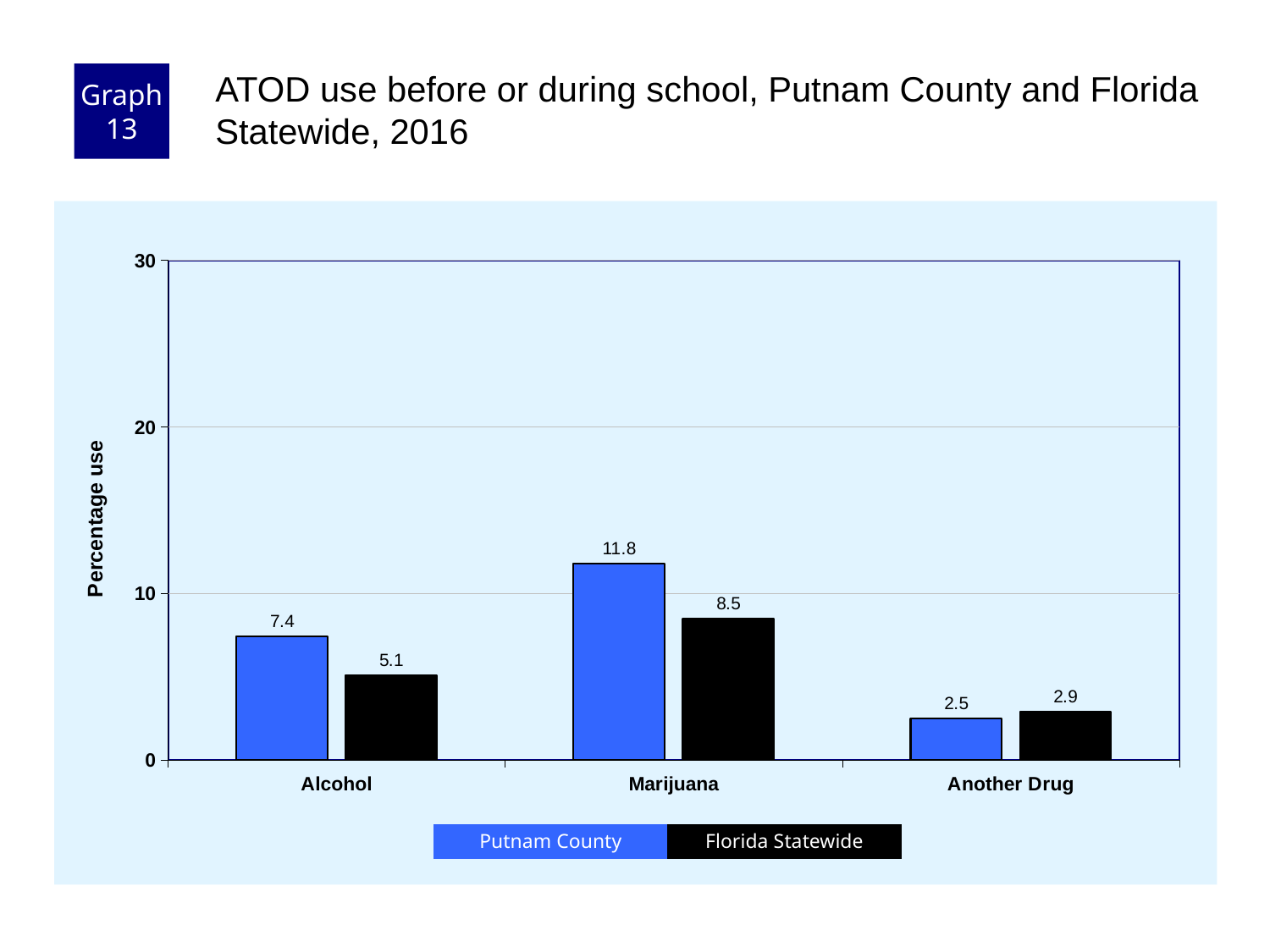
Which category has the lowest Florida Statewide value? Another Drug What is the difference between the Putnam County and Florida Statewide values for Alcohol? 2.3 What is the Florida Statewide value for Another Drug? 2.9 Is the Putnam County value for Marijuana greater or less than 10? greater Which category has the highest Putnam County value? Marijuana What is the Florida Statewide value for Alcohol? 5.1 What is the Putnam County value for Marijuana? 11.8 What kind of chart is shown on the slide? Bar chart What is the difference between the Putnam County and Florida Statewide values for Marijuana? 3.3 How many categories are shown on the x axis? 3 How many series does the legend list? 2 For Another Drug, which is larger: Putnam County or Florida Statewide? Florida Statewide